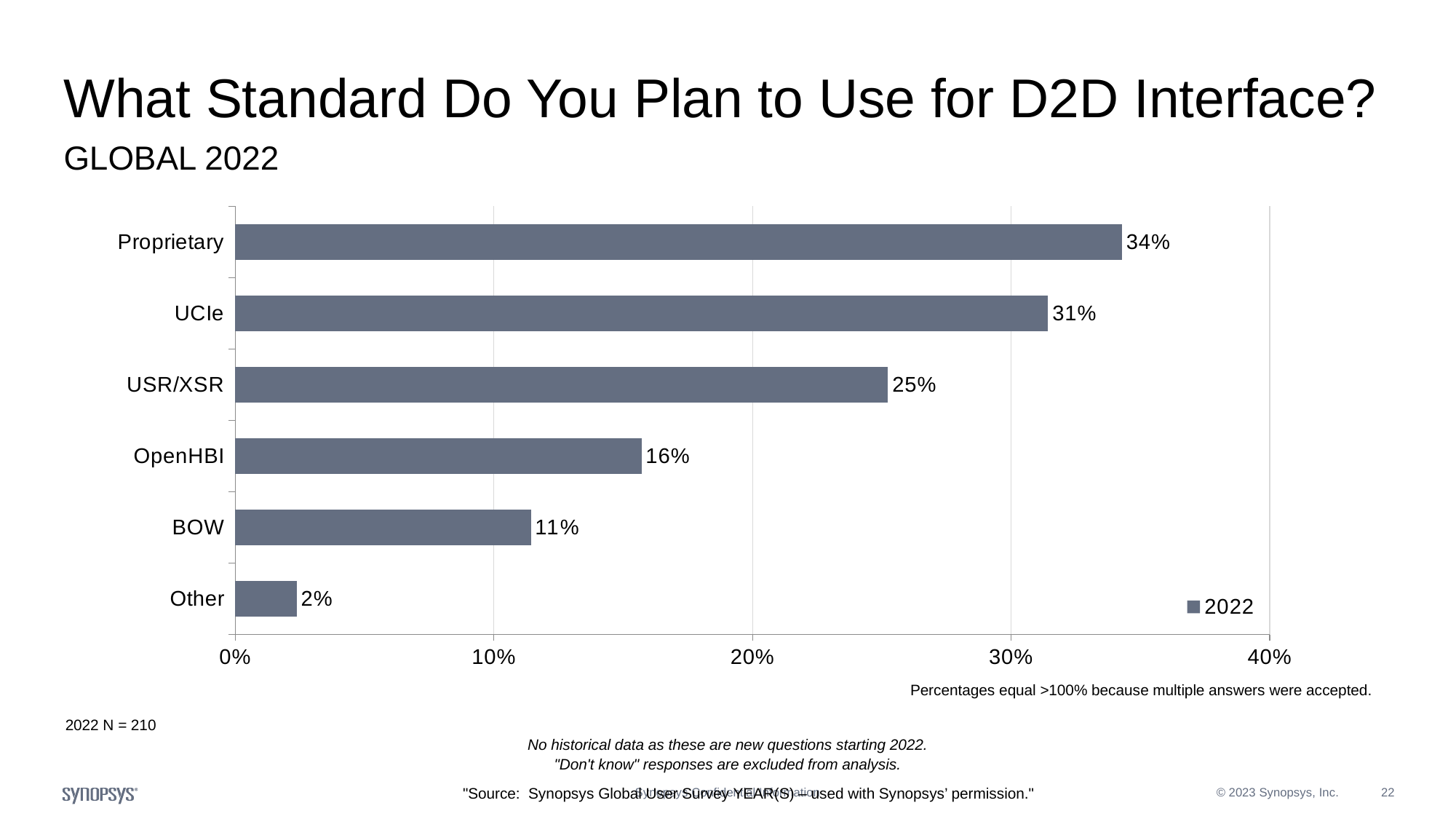
Is the value for UCIe greater or less than 30%? greater What is the value shown for BOW? 11% Which category has the highest value? Proprietary How many categories are shown on the chart? 6 What is the value shown for OpenHBI? 16% Which category has the lowest value? Other What kind of chart is shown on the slide? Bar chart What series does the legend list? 2022 What percentage of respondents plan to use UCIe for the D2D interface? 31% Which is larger, the value for USR/XSR or the value for OpenHBI? USR/XSR What is the difference between the values for USR/XSR and BOW? 14% What is the difference between the values for Proprietary and UCIe? 3%